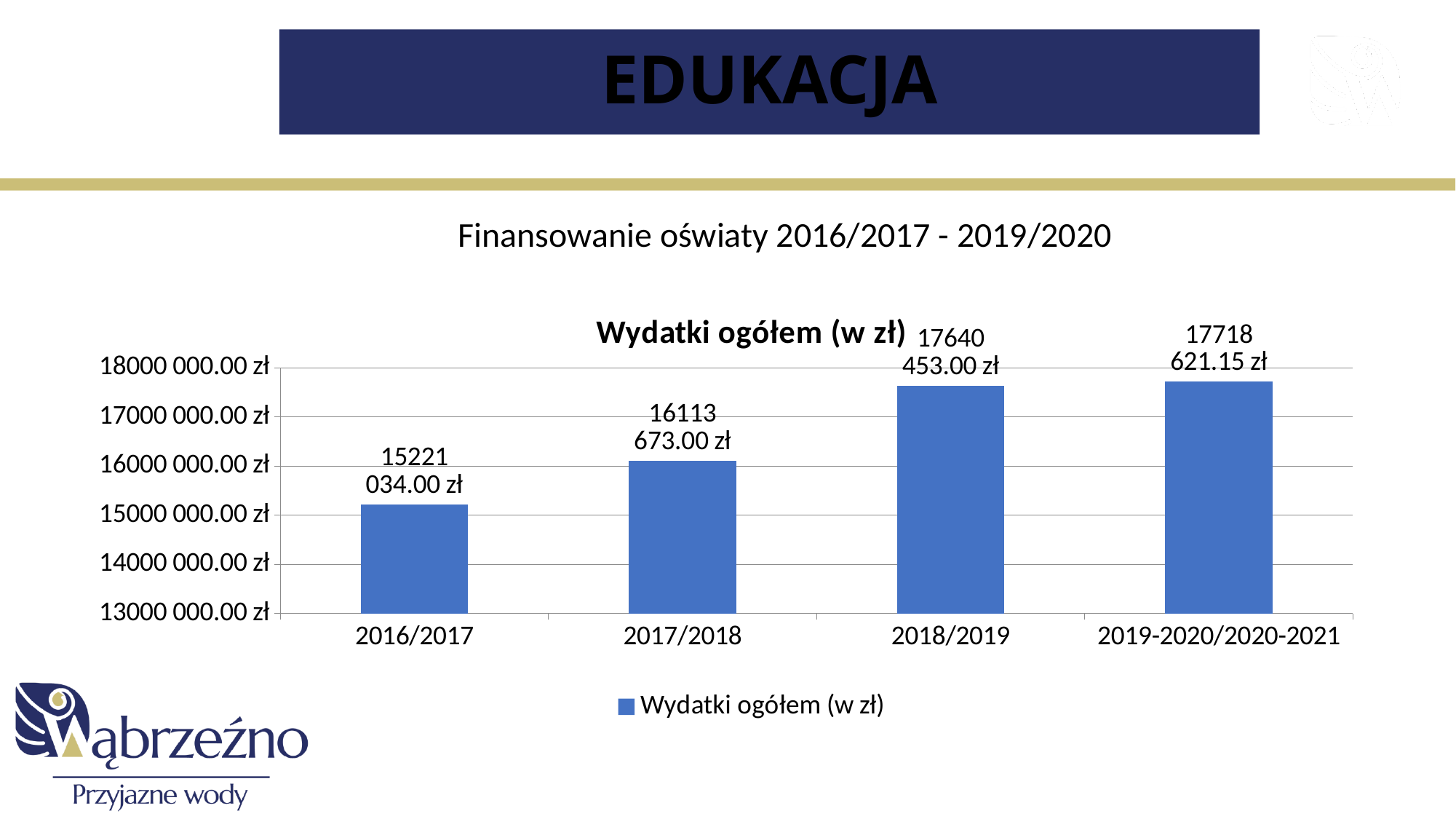
What is the difference between the values for 2017/2018 and 2016/2017? 892 639.00 zł What kind of chart is shown on the slide? bar chart What is the value for 2019-2020/2020-2021 in the Wydatki ogółem (w zł) chart? 17718 621.15 zł Which category has the lowest value in the Wydatki ogółem (w zł) chart? 2016/2017 What is the value for 2018/2019 in the Wydatki ogółem (w zł) chart? 17640 453.00 zł What is the value for 2017/2018 in the Wydatki ogółem (w zł) chart? 16113 673.00 zł Do the values rise or fall from 2016/2017 to 2019-2020/2020-2021? rise Which is larger, the value for 2017/2018 or the value for 2018/2019? 2018/2019 How many categories are shown on the x axis of the chart? 4 Which category has the highest value in the Wydatki ogółem (w zł) chart? 2019-2020/2020-2021 What is the value for 2016/2017 in the Wydatki ogółem (w zł) chart? 15221 034.00 zł What is the difference between the values for 2019-2020/2020-2021 and 2018/2019? 78 168.15 zł